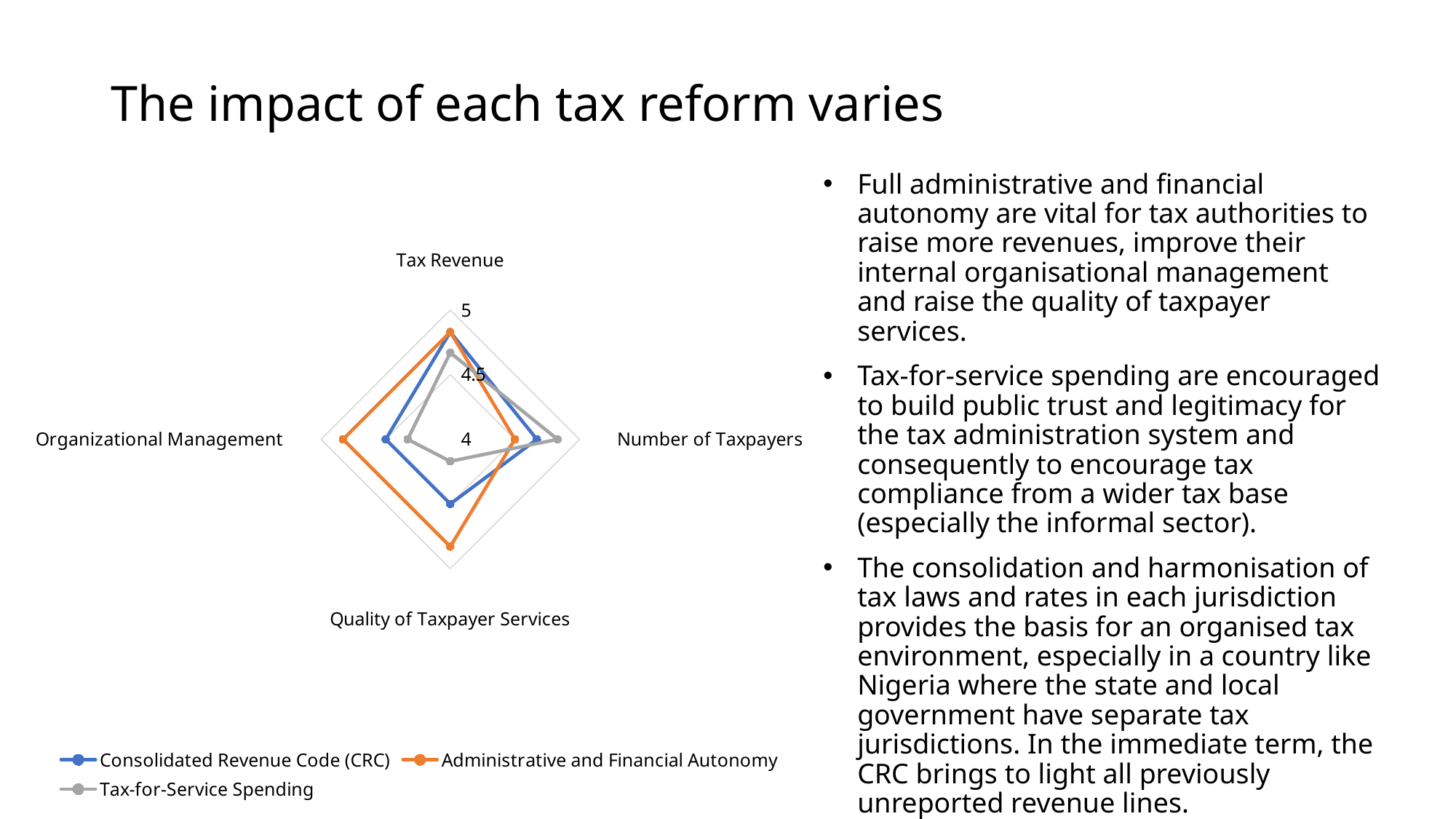
Which colour represents Administrative and Financial Autonomy in the chart? Orange Is the value of Consolidated Revenue Code (CRC) for Tax Revenue greater or less than 4.5? greater For Number of Taxpayers, which is larger: Tax-for-Service Spending or Administrative and Financial Autonomy? Tax-for-Service Spending In which category does Administrative and Financial Autonomy have its lowest value? Number of Taxpayers For Quality of Taxpayer Services, which is larger: Administrative and Financial Autonomy or Tax-for-Service Spending? Administrative and Financial Autonomy What kind of chart is shown on the slide? Radar chart Is the value of Administrative and Financial Autonomy for Quality of Taxpayer Services greater or less than 4.5? greater In which category does Tax-for-Service Spending have its lowest value? Quality of Taxpayer Services Is the value of Tax-for-Service Spending for Quality of Taxpayer Services greater or less than 4.5? less How many categories (axes) does the radar chart have? 4 How many series does the chart legend list? 3